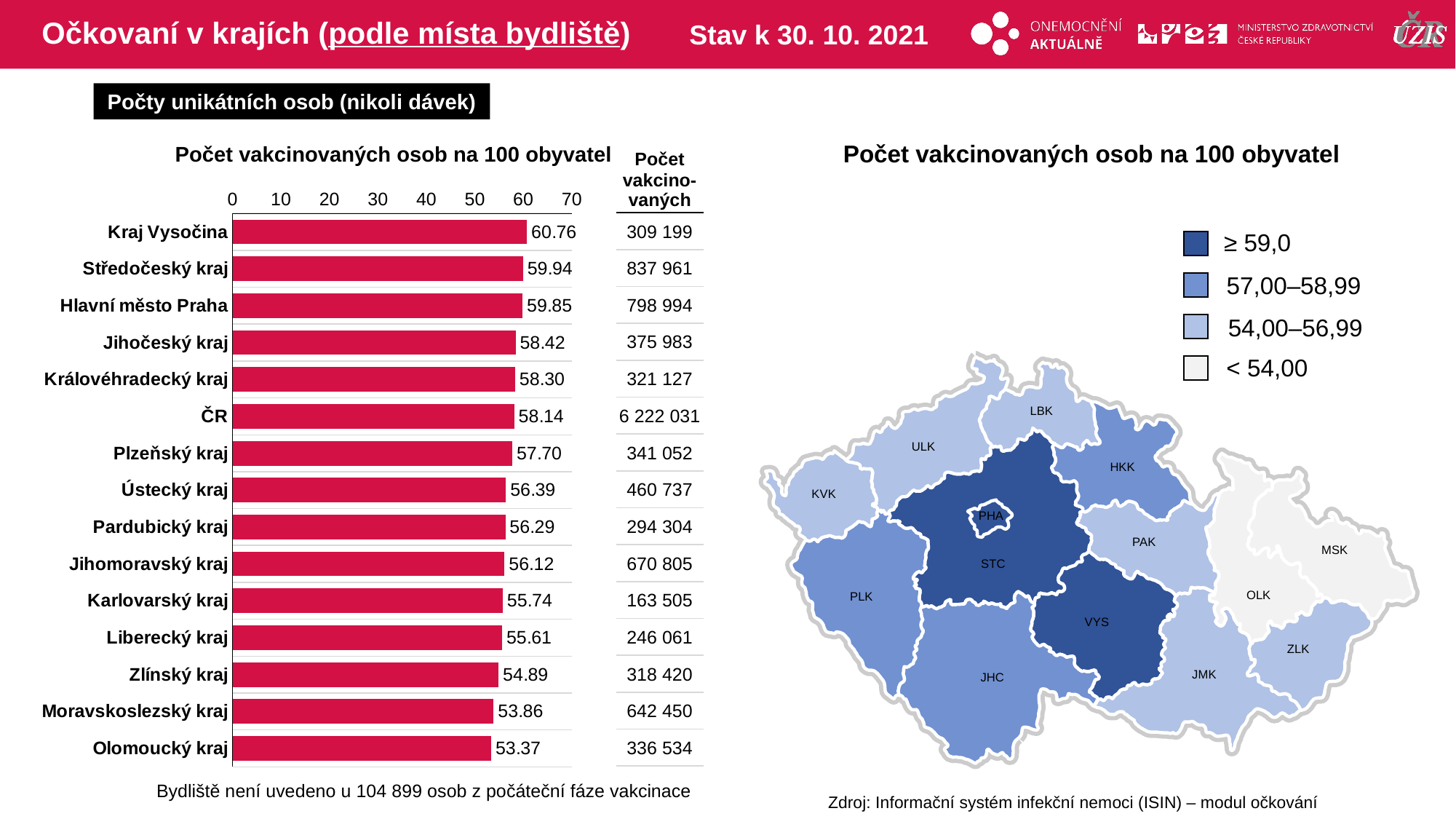
In the bar chart, which category has the highest value? Kraj Vysočina In the bar chart, what is the value for Kraj Vysočina? 60.76 In the bar chart, which has a larger value, Plzeňský kraj or Ústecký kraj? Plzeňský kraj What is the title of the bar chart on the left? Počet vakcinovaných osob na 100 obyvatel In the bar chart, what is the value for Olomoucký kraj? 53.37 What kind of chart is shown on the left of the slide? bar chart In the bar chart, is the value for Středočeský kraj greater or less than 50? greater In the bar chart, what is the difference between the values for Kraj Vysočina and Olomoucký kraj? 7.39 In the bar chart, what is the value for ČR? 58.14 How many categories (bars) does the bar chart show? 15 In the bar chart, what is the difference between the values for Středočeský kraj and Hlavní město Praha? 0.09 In the bar chart, which category has the lowest value? Olomoucký kraj